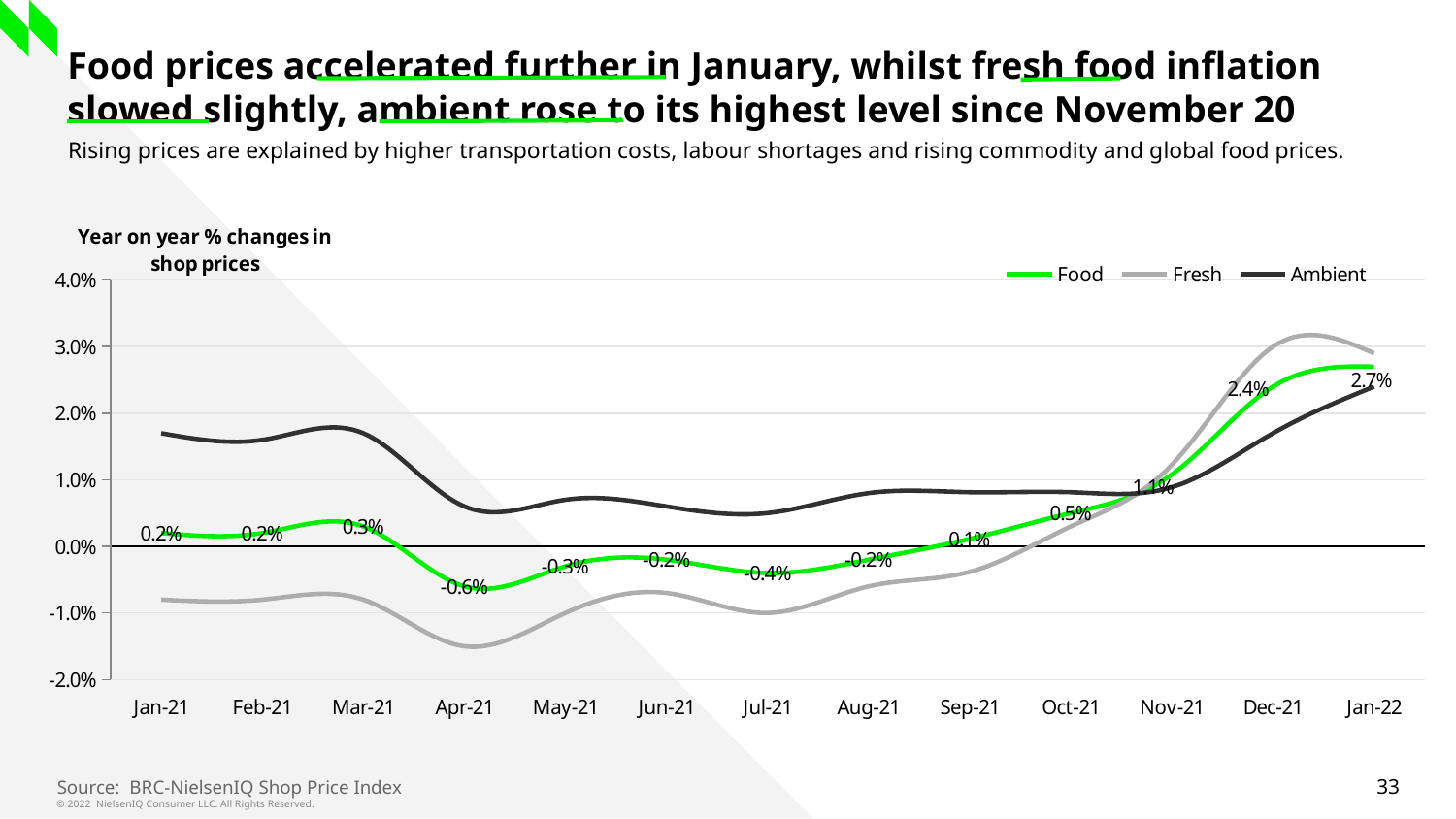
In which month is the Food series at its highest? Jan-22 By how many percentage points did the Food value change from Dec-21 to Jan-22? 0.3 percentage points Which is larger, the Food value for Oct-21 or for Sep-21? Oct-21 What is the Food value for Nov-21? 1.1% How many series does the legend list? 3 Is the Fresh value for Apr-21 greater or less than -1.0%? less In which month is the Food series at its lowest? Apr-21 What is the Food value for Apr-21? -0.6% What kind of chart is shown on the slide? Line chart How many months are plotted on the x axis? 13 Is the Ambient value for Jan-21 greater or less than 1.0%? greater What is the Food value for Dec-21? 2.4%